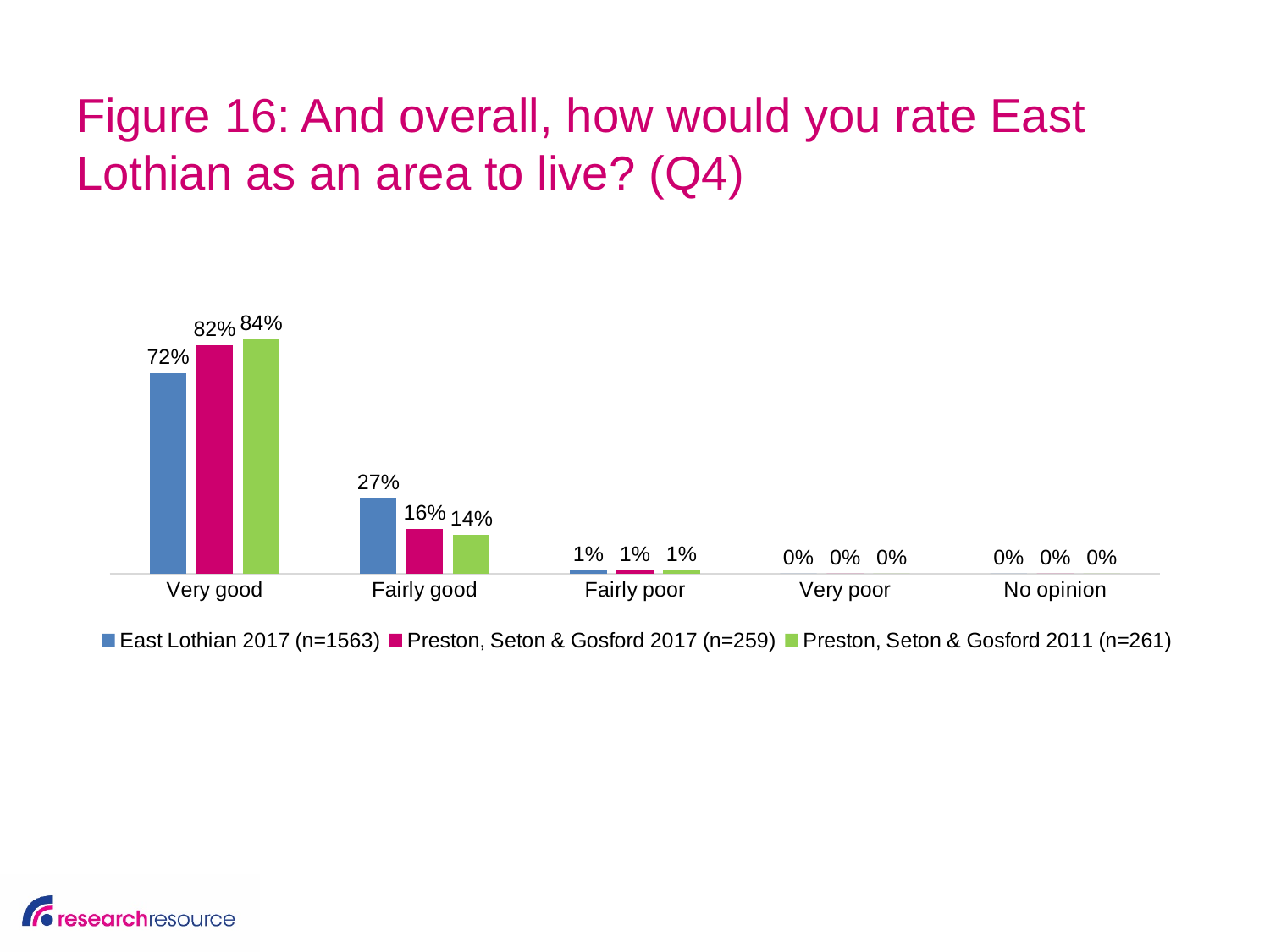
Which series has the highest value in the 'Very good' category? Preston, Seton & Gosford 2011 (n=261) Which category has the highest value for the East Lothian 2017 series? Very good What percentage of East Lothian 2017 respondents rated the area as 'Very good'? 72% What is the difference between the East Lothian 2017 and Preston, Seton & Gosford 2017 values for 'Fairly good'? 11 percentage points What is the value for Preston, Seton & Gosford 2017 in the 'Very good' category? 82% What kind of chart is shown on the slide? Bar chart How many series does the legend list? 3 What is the value for all three series in the 'Very poor' category? 0% How many response categories are shown on the x axis? 5 Which is larger for 'Fairly good': East Lothian 2017 or Preston, Seton & Gosford 2011? East Lothian 2017 What is the value for Preston, Seton & Gosford 2011 in the 'Fairly good' category? 14% What is the difference between the Preston, Seton & Gosford 2011 and East Lothian 2017 values for 'Very good'? 12 percentage points